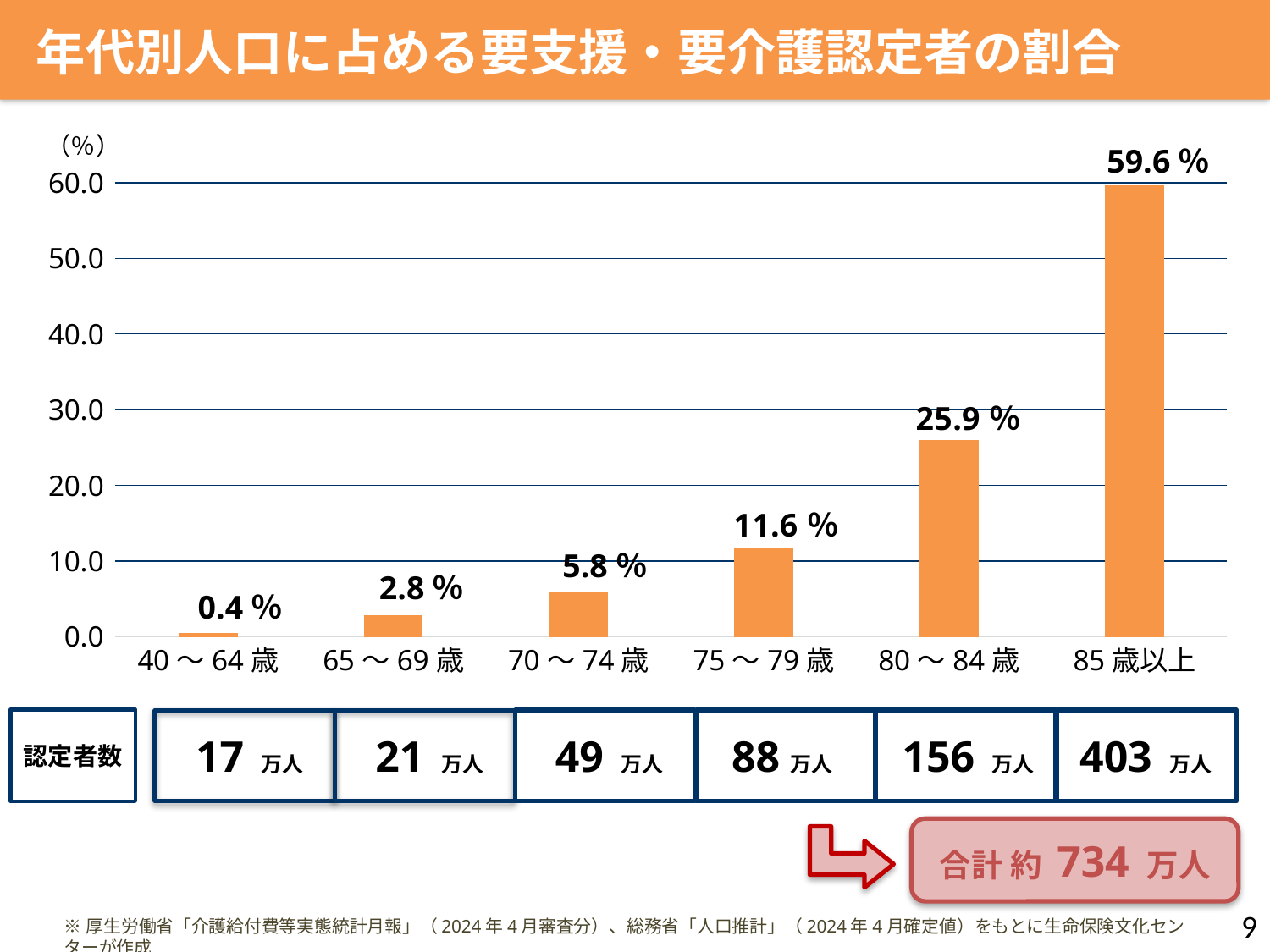
Which is larger, the value for 80～84歳 or the value for 75～79歳? 80～84歳 What is the difference between the values for 85歳以上 and 80～84歳? 33.7 % What is the value shown for the 85歳以上 age group? 59.6 % How many age groups are shown in the chart? 6 What kind of chart is shown on the slide? bar chart Which age group has the lowest value in the chart? 40～64歳 What is the value shown for the 40～64歳 age group? 0.4 % Which age group has the highest value in the chart? 85歳以上 Do the values rise or fall as the age groups move from left to right along the x axis? rise What is the difference between the values for 70～74歳 and 65～69歳? 3.0 % What is the value shown for the 75～79歳 age group? 11.6 % Is the value for 80～84歳 greater or less than 30.0? less